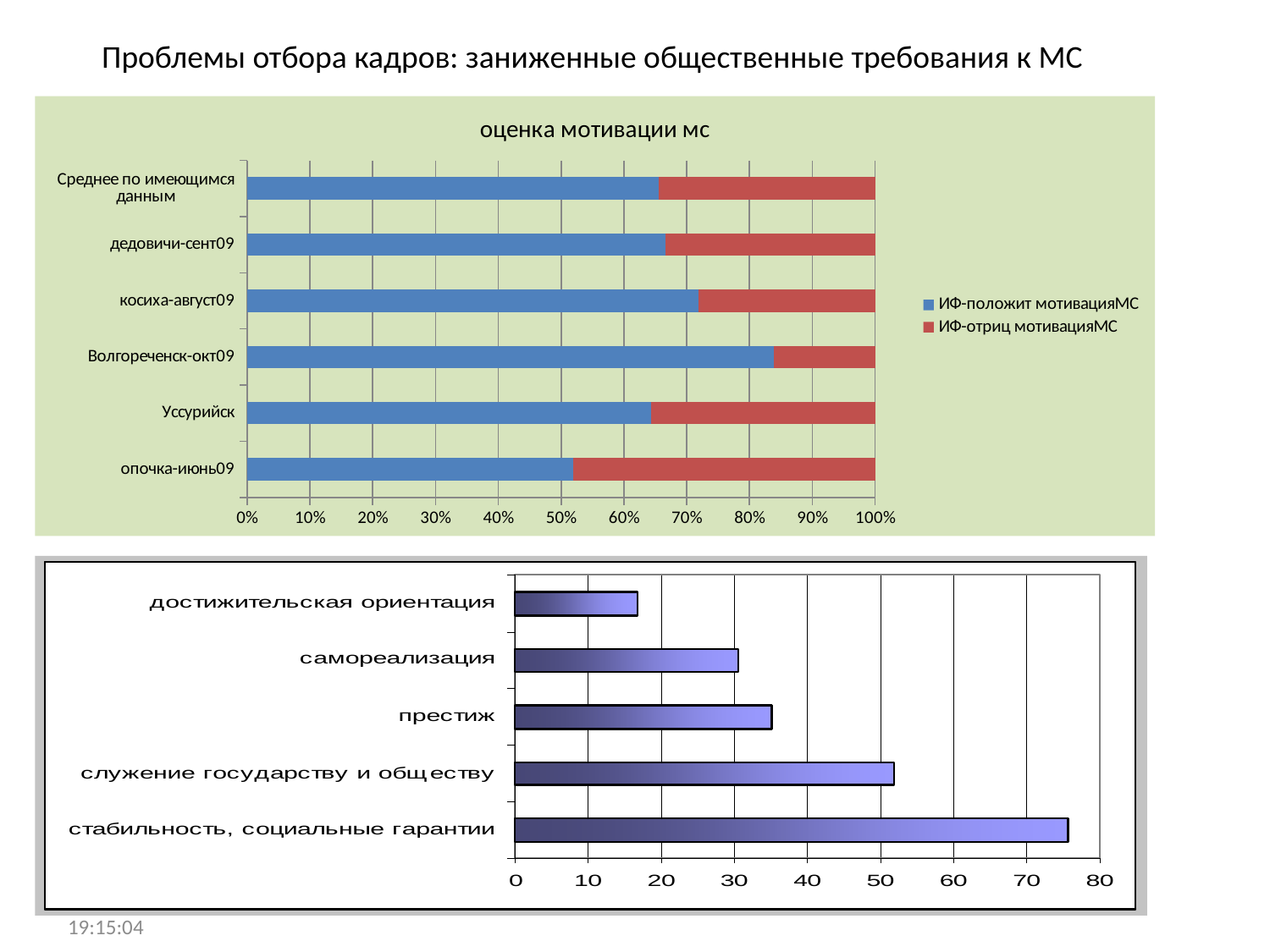
In the chart titled 'оценка мотивации мс', is the 'ИФ-положит мотивацияМС' share for Волгореченск-окт09 greater or less than 80%? greater In the chart titled 'оценка мотивации мс', which category has the largest share of 'ИФ-положит мотивацияМС'? Волгореченск-окт09 In the bottom chart, which category has the highest value? стабильность, социальные гарантии In the bottom chart, which category has the lowest value? достижительская ориентация In the chart titled 'оценка мотивации мс', what kind of chart is it? bar chart In the chart titled 'оценка мотивации мс', which category has the smallest share of 'ИФ-положит мотивацияМС'? опочка-июнь09 In the chart titled 'оценка мотивации мс', how many series does the legend list? 2 In the chart titled 'оценка мотивации мс', how many categories are shown on the vertical axis? 6 In the chart titled 'оценка мотивации мс', is the 'ИФ-положит мотивацияМС' share for опочка-июнь09 greater or less than 60%? less In the bottom chart, how many categories are shown? 5 In the chart titled 'оценка мотивации мс', which colour represents 'ИФ-отриц мотивацияМС'? red In the bottom chart, is the value for 'стабильность, социальные гарантии' greater or less than 70? greater